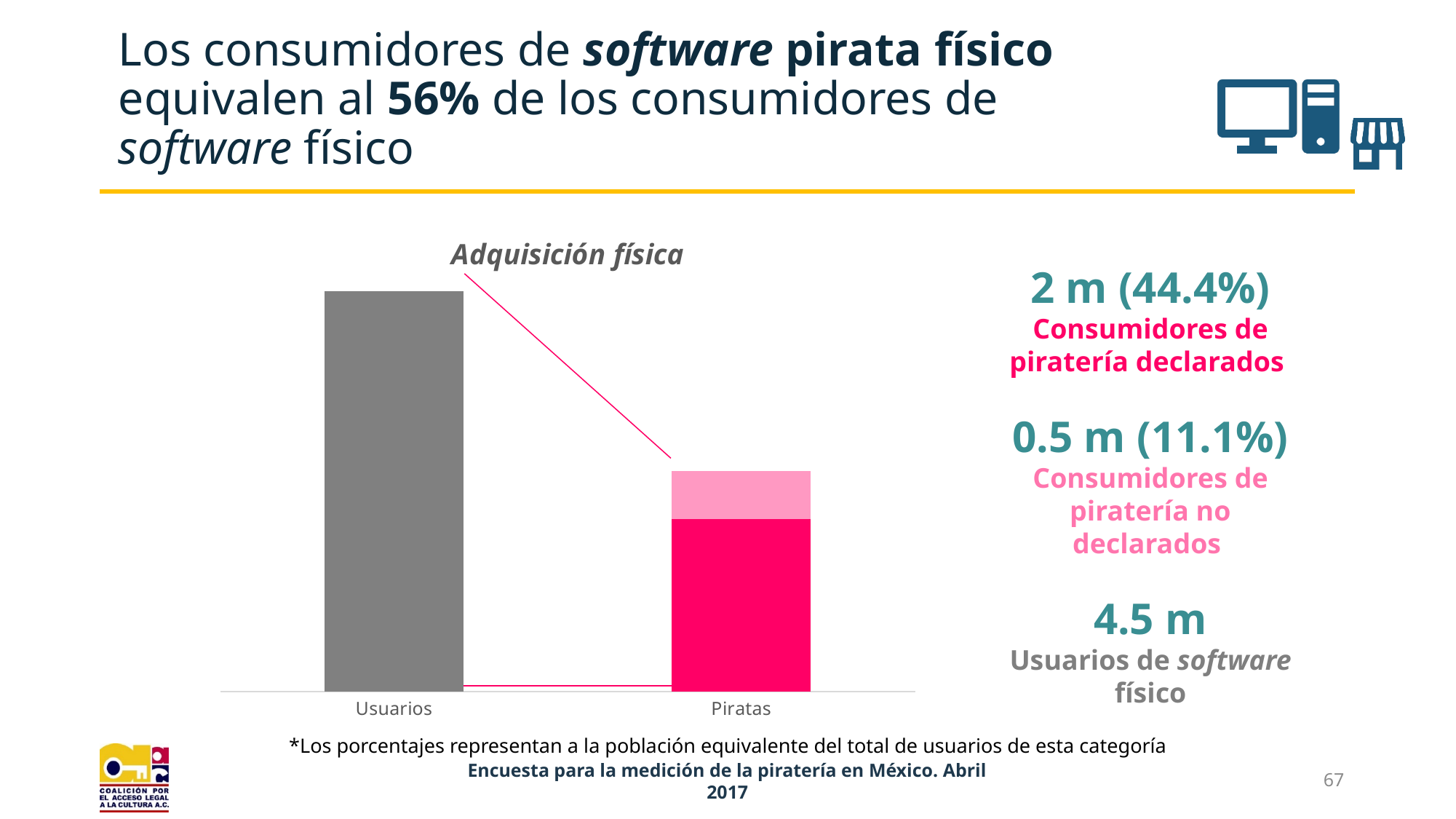
Which category has the taller bar, Usuarios or Piratas? Usuarios What colour is the Usuarios bar in the chart? Gray According to the slide, how many declared piracy consumers (Consumidores de piratería declarados) are there? 2 m (44.4%) What kind of chart is shown on the slide? Bar chart What is the total of the stacked Piratas bar, adding declared and non-declared piracy consumers? 2.5 m Which category has the shorter bar in the chart? Piratas Is the bar for Usuarios larger or smaller than the bar for Piratas? Larger How many categories are shown on the x axis of the chart? 2 What percentage of physical software users do declared piracy consumers represent, according to the slide? 44.4% According to the slide, how many non-declared piracy consumers (Consumidores de piratería no declarados) are there? 0.5 m (11.1%) What is the title of the chart? Adquisición física According to the slide, how many users of physical software (Usuarios de software físico) are there? 4.5 m